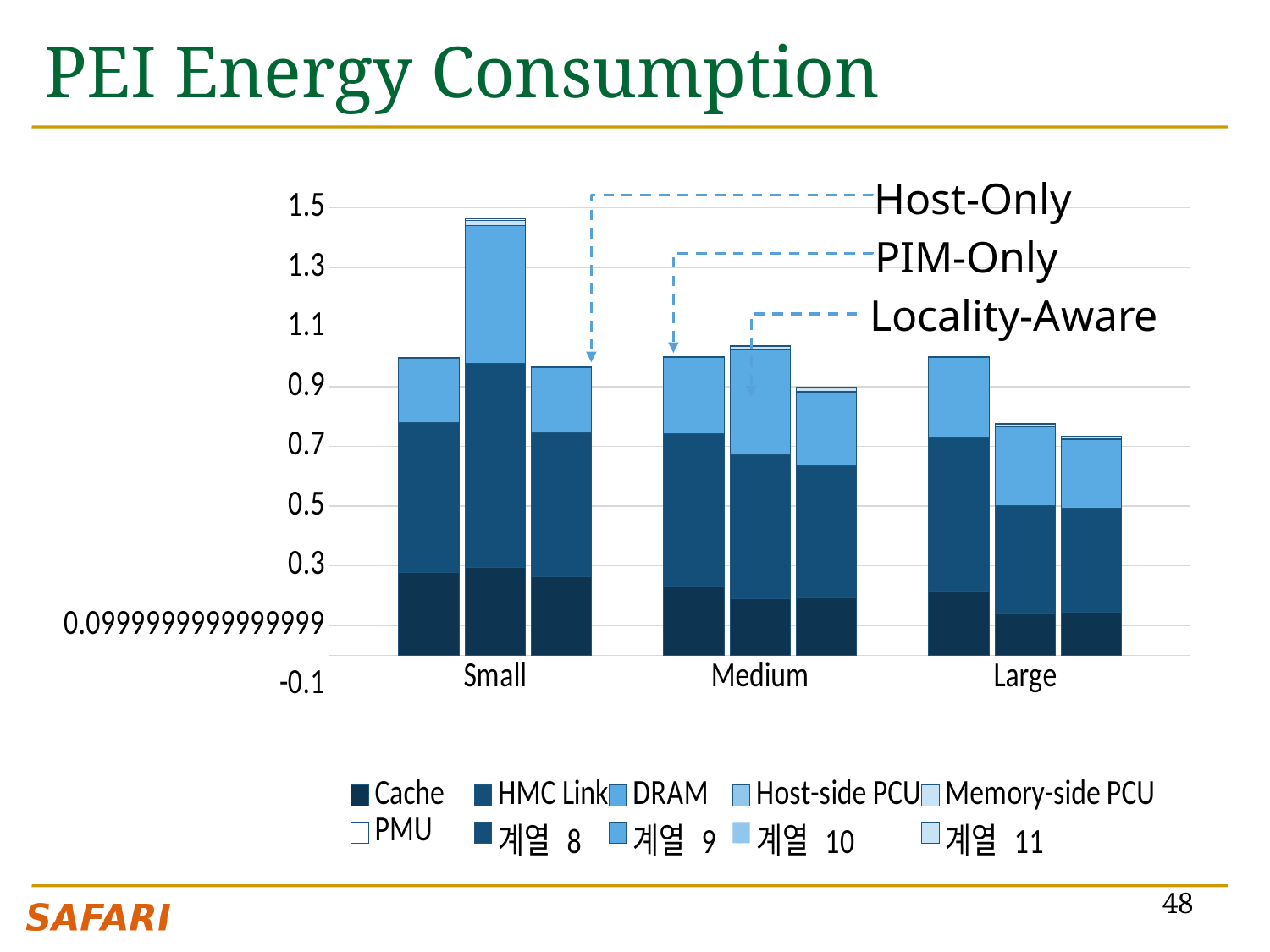
Is the total of the Locality-Aware bar for Large greater or less than 0.9? less Is the total of the Host-Only bar for Medium greater or less than 0.9? greater How many series does the chart legend list? 10 Do the Locality-Aware bars rise or fall from Small to Large? fall For the Small category, which bar is taller: Host-Only or PIM-Only? PIM-Only What is the title of the slide containing the chart? PEI Energy Consumption For the Large category, which bar is taller: Host-Only or Locality-Aware? Host-Only Is the total of the PIM-Only bar for Small greater or less than 1.3? greater What kind of chart is shown on the slide? stacked bar chart How many categories are shown on the x axis of the chart? 3 Which category has the tallest stacked bar in the chart? Small Which three configurations are labelled by the dashed arrows pointing at the bars? Host-Only, PIM-Only, Locality-Aware